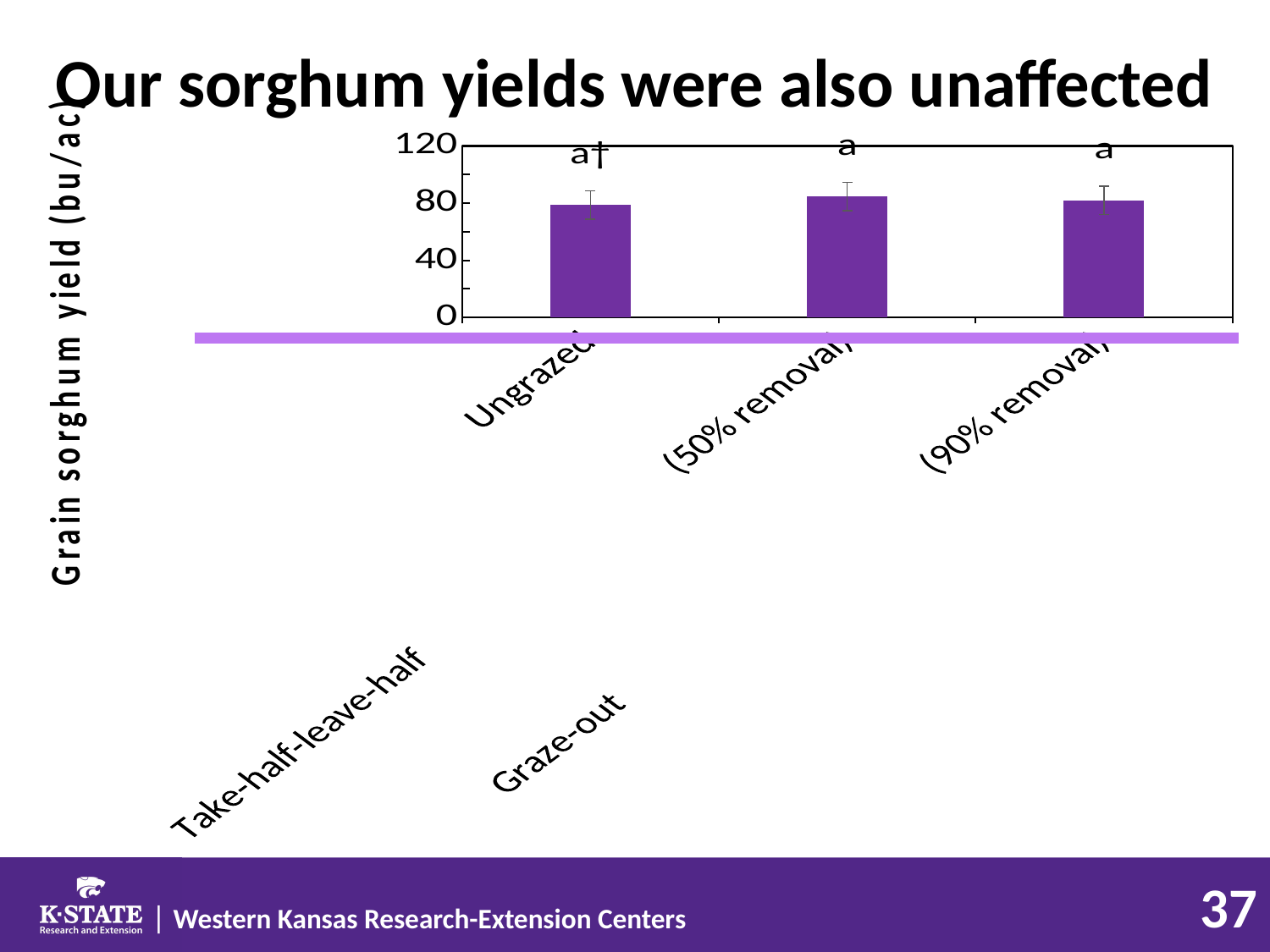
How many bars (categories) are plotted in the chart? 3 Is the value for (50% removal) greater or less than 40? greater Is the value for Ungrazed greater or less than 40? greater What letter is printed above each of the three bars in the chart? a Is the value for (90% removal) greater or less than 120? less What kind of chart is shown on the slide? bar chart What is the label of the vertical axis of the chart? Grain sorghum yield (bu/ac)